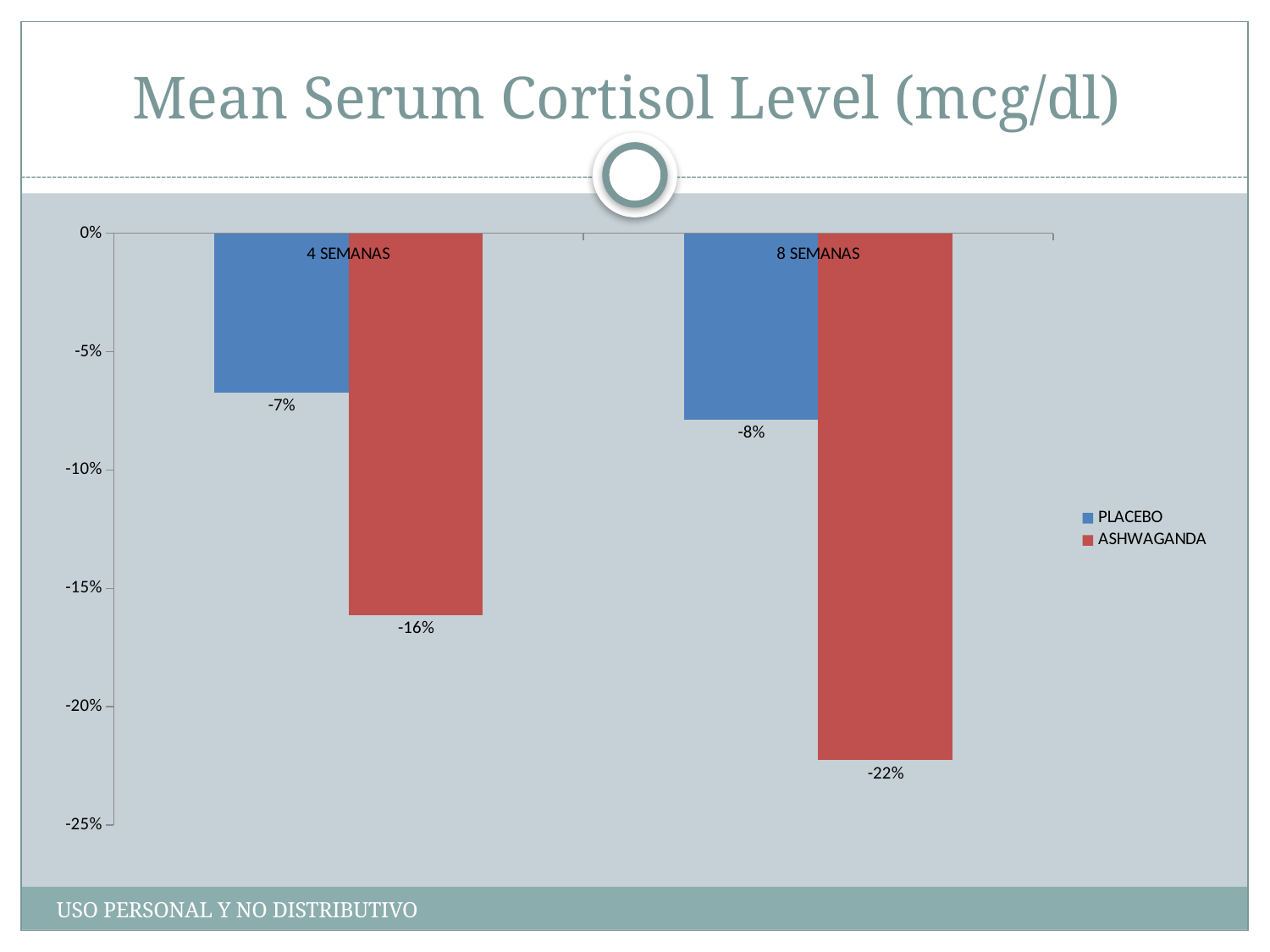
What is the value for ASHWAGANDA at 8 SEMANAS? -22% Which bar shows the smallest decrease? PLACEBO at 4 SEMANAS What is the value for ASHWAGANDA at 4 SEMANAS? -16% How many categories are shown on the x axis? 2 Which bar shows the largest decrease? ASHWAGANDA at 8 SEMANAS What is the difference between the ASHWAGANDA values at 4 SEMANAS and 8 SEMANAS? 6 percentage points What kind of chart is shown on the slide? Bar chart Which series shows a larger decrease at 4 SEMANAS, PLACEBO or ASHWAGANDA? ASHWAGANDA What is the difference between the ASHWAGANDA and PLACEBO values at 8 SEMANAS? 14 percentage points What is the value for PLACEBO at 8 SEMANAS? -8% How many series does the legend list? 2 What is the value for PLACEBO at 4 SEMANAS? -7%